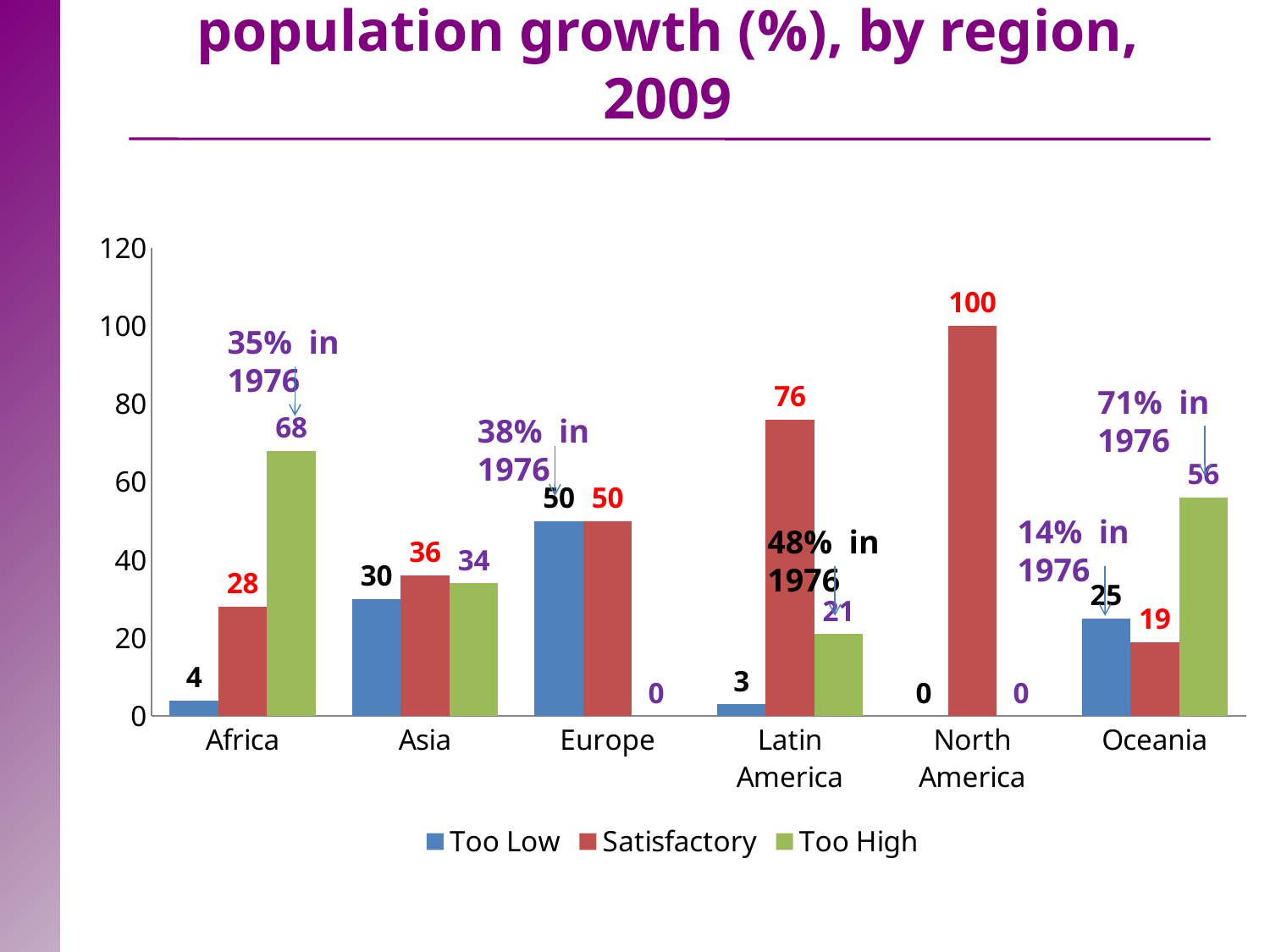
Which region has the lowest Too High value, excluding the regions with 0? Latin America What is the difference between the Too High values for Africa and Oceania? 12 Which is larger, the Too Low value for Asia or the Too Low value for Oceania? Asia What kind of chart is shown on the slide? bar chart What is the value for Too High in Africa? 68 How many regions are shown on the x axis? 6 How many series does the legend list? 3 What is the Satisfactory value for North America? 100 According to the annotation, what was the Too High percentage for Oceania in 1976? 71% What is the Too Low value for Oceania? 25 Is the Satisfactory value for Latin America greater or less than 60? greater Which region has the highest Satisfactory value? North America